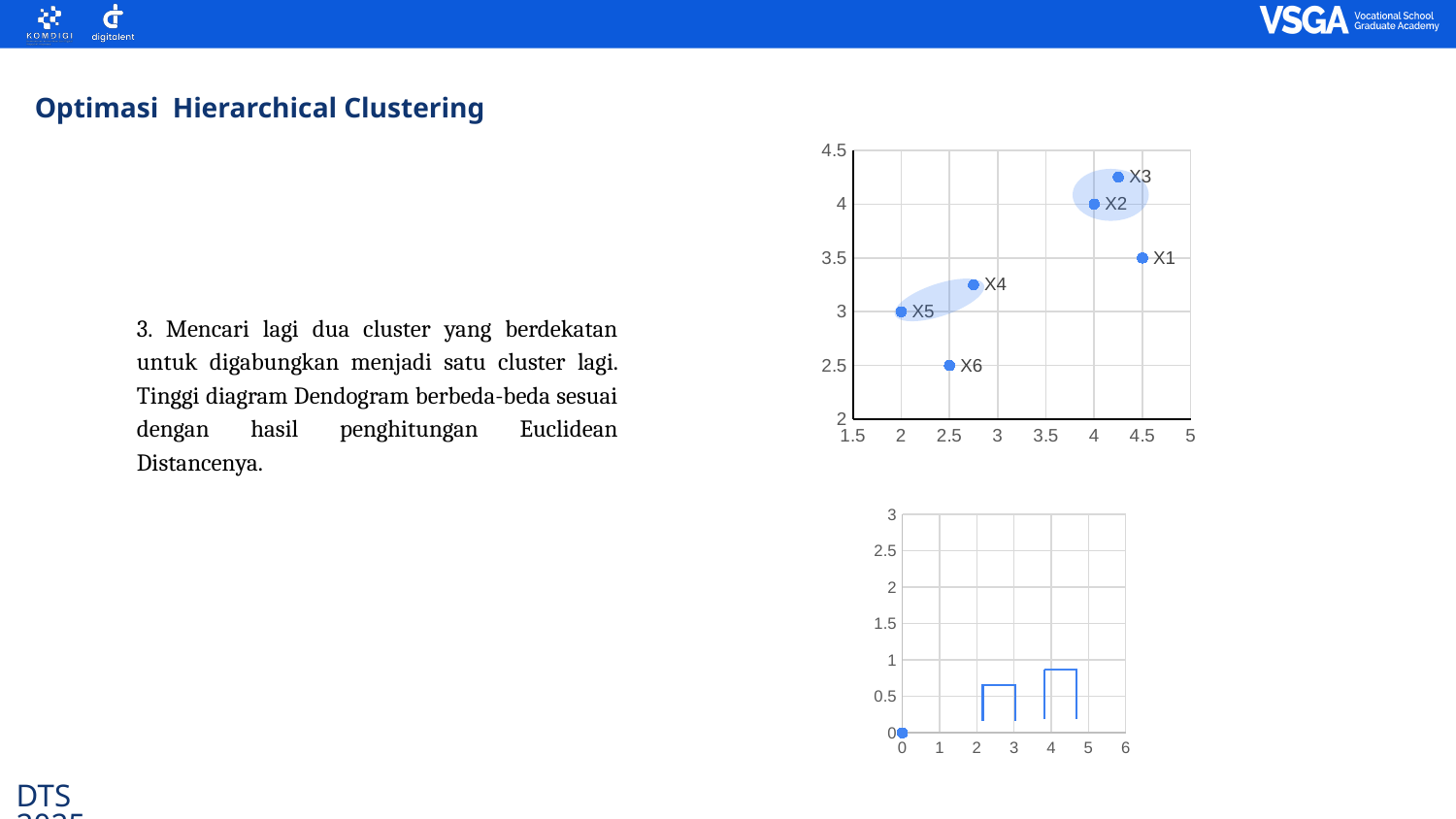
In the top chart, what is the x-value of point X5? 2 In the top chart, what is the y-value of point X6? 2.5 In the bottom chart, is the height of the taller bracket greater or less than 1? less What kind of chart is the top chart on the slide? scatter chart In the top chart, how many labelled data points are plotted? 6 In the top chart, is the y-value of X3 greater or less than 4? greater In the top chart, which point is furthest to the left (lowest x-value)? X5 In the top chart, which point has the lowest y-value? X6 In the top chart, which point has the larger y-value, X1 or X2? X2 In the top chart, which point is furthest to the right (highest x-value)? X1 In the top chart, which point has the highest y-value? X3 In the top chart, what is the y-value of point X2? 4